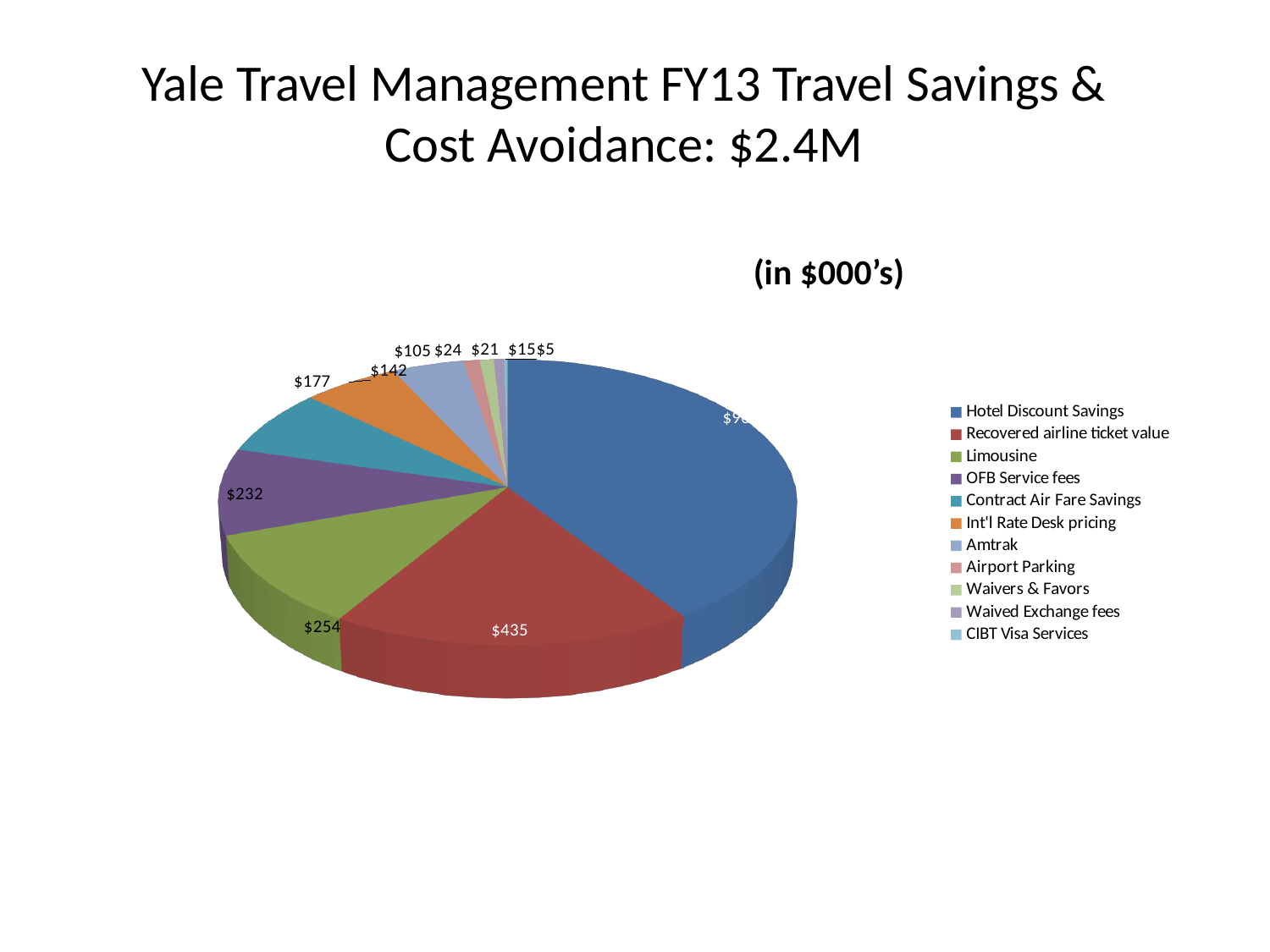
What is the value for Recovered airline ticket value? $435 What is the value for OFB Service fees? $232 What is the value for CIBT Visa Services? $5 What is the difference between OFB Service fees and Contract Air Fare Savings? $55 What is the difference between Recovered airline ticket value and Limousine? $181 What is the value for Limousine? $254 Which category has the largest slice of the pie? Hotel Discount Savings What is the value for Amtrak? $105 Which is larger, Int'l Rate Desk pricing or Amtrak? Int'l Rate Desk pricing What kind of chart is shown on the slide? Pie chart How many categories are shown in the pie chart? 11 Which category has the smallest slice of the pie? CIBT Visa Services